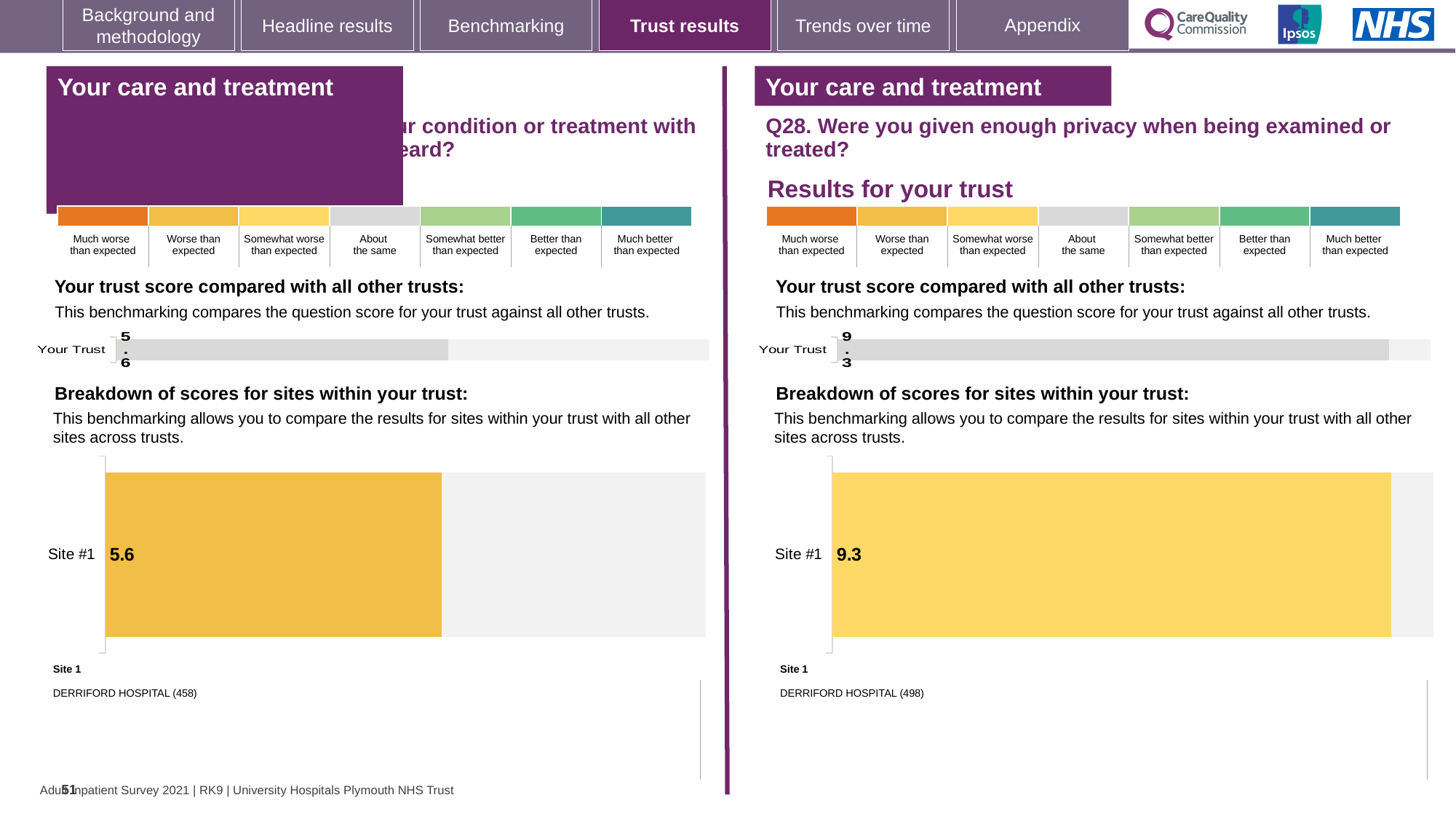
On the left-hand site breakdown chart, which hospital is Site 1? DERRIFORD HOSPITAL (458) On the right-hand Q28 chart, is the Site #1 score greater or less than 9? greater On the left-hand chart, what is the score shown for Your Trust? 5.6 On the right-hand chart for Q28 (privacy when being examined or treated), what is the score shown for Your Trust? 9.3 What type of chart is used for the site breakdown on the left-hand panel? Bar chart Which is larger: the Site #1 score on the left-hand chart or the Site #1 score on the right-hand Q28 chart? The right-hand Q28 chart How many sites are shown in the site breakdown chart on the right-hand Q28 panel? 1 On the right-hand site breakdown chart for Q28, what is the score for Site #1? 9.3 On the left-hand site breakdown chart, what is the score for Site #1? 5.6 On the left-hand chart, is the Site #1 score greater or less than 6? less On the right-hand Q28 site breakdown chart, which hospital is Site 1? DERRIFORD HOSPITAL (498) What is the difference between the Site #1 score on the right-hand Q28 chart and the Site #1 score on the left-hand chart? 3.7